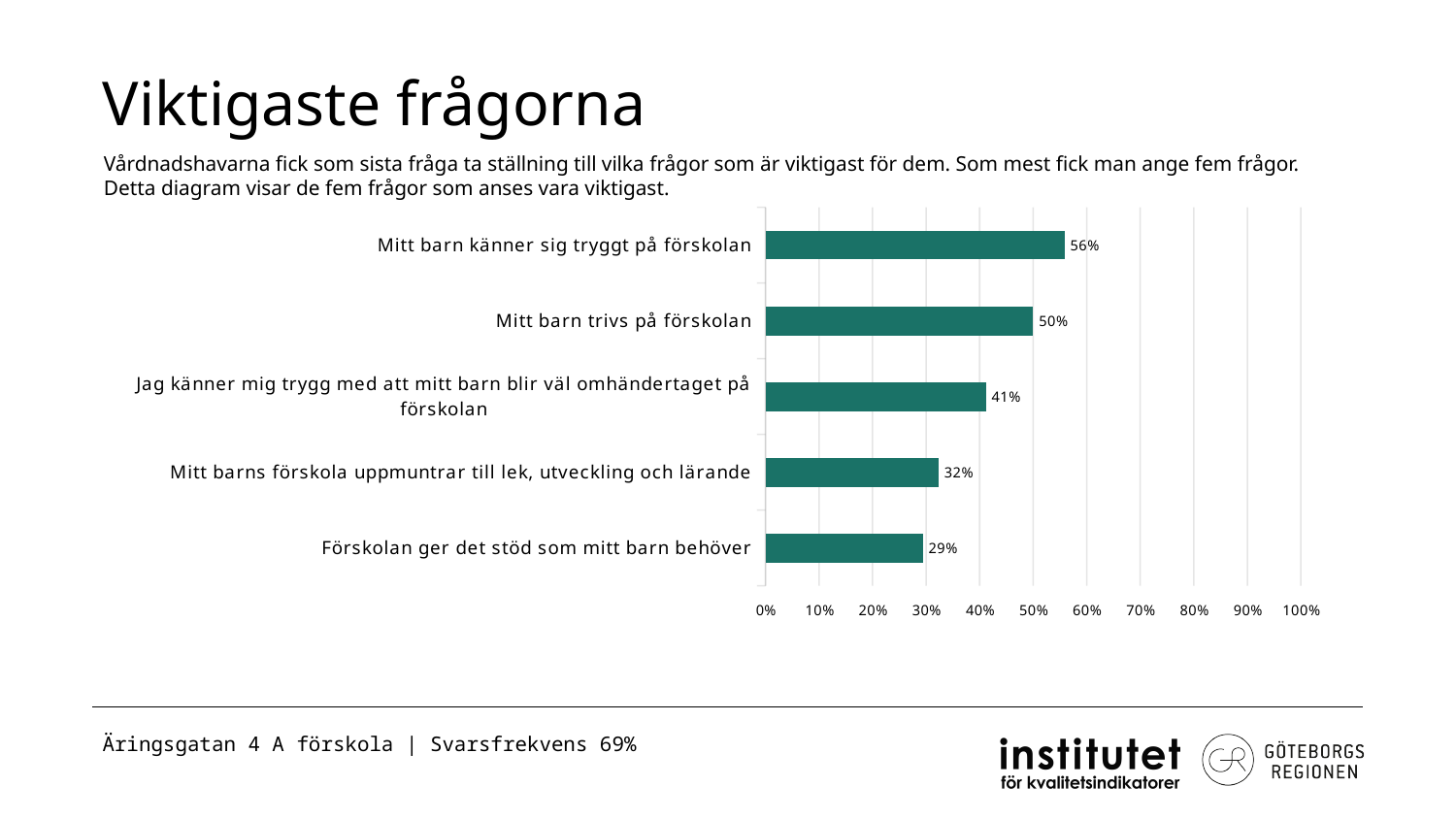
Which category has the highest value? Mitt barn känner sig tryggt på förskolan What is the difference between the values for "Mitt barn känner sig tryggt på förskolan" and "Mitt barn trivs på förskolan"? 6% Which category has the lowest value? Förskolan ger det stöd som mitt barn behöver What is the difference between the values for "Mitt barns förskola uppmuntrar till lek, utveckling och lärande" and "Förskolan ger det stöd som mitt barn behöver"? 3% What is the value for "Mitt barn trivs på förskolan"? 50% What is the value for "Mitt barn känner sig tryggt på förskolan"? 56% How many categories are shown in the chart? 5 What kind of chart is shown on the slide? Bar chart What is the value for "Förskolan ger det stöd som mitt barn behöver"? 29% What is the title of the slide containing the chart? Viktigaste frågorna Which is larger, the value for "Jag känner mig trygg med att mitt barn blir väl omhändertaget på förskolan" or the value for "Mitt barns förskola uppmuntrar till lek, utveckling och lärande"? Jag känner mig trygg med att mitt barn blir väl omhändertaget på förskolan What is the value for "Jag känner mig trygg med att mitt barn blir väl omhändertaget på förskolan"? 41%